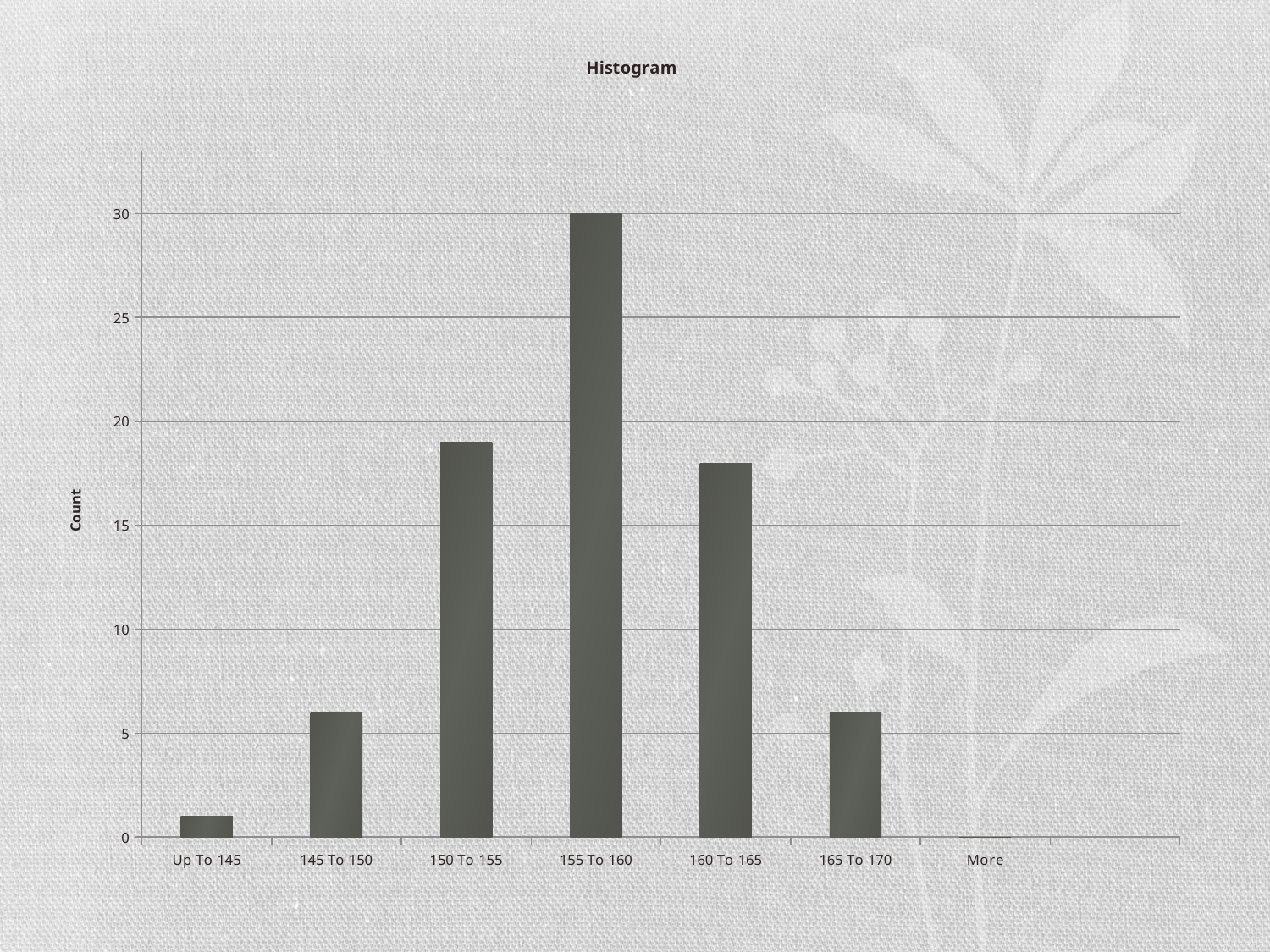
What is the label on the vertical axis? Count Which category has the highest count? 155 To 160 Which has a larger count, 150 To 155 or 145 To 150? 150 To 155 Which category has the lowest count? More What kind of chart is shown on the slide? bar chart What is the count for the 155 To 160 category? 30 What is the title of the chart? Histogram How many categories are shown on the x axis? 7 Is the count for 145 To 150 greater or less than 5? greater Do the counts rise or fall from 155 To 160 through 165 To 170? fall Is the count for 150 To 155 greater or less than 20? less Is the count for 160 To 165 greater or less than 15? greater